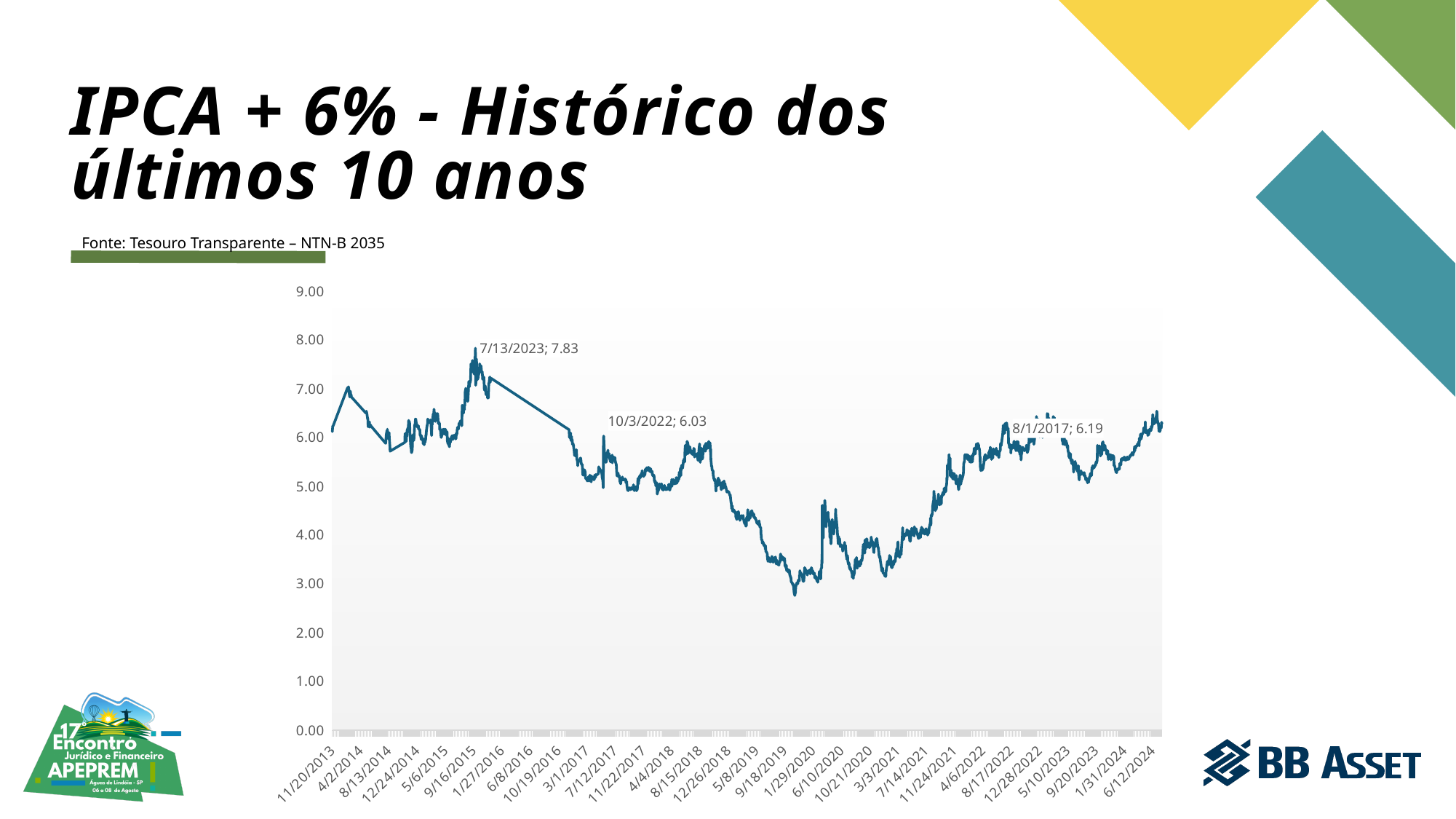
Is the value of the line at 11/20/2013 greater or less than 5.00? greater What source is cited for the chart data? Tesouro Transparente – NTN-B 2035 What value is labeled on the chart for 10/3/2022? 6.03 How many data points on the chart have printed value labels? 3 Is the value of the line around 1/29/2020 greater or less than 4.00? less What kind of chart is shown on the slide? line chart Of the three labeled points on the chart, which date has the lowest value? 10/3/2022 What value is labeled on the chart for 7/13/2023? 7.83 What is the difference between the labeled values for 7/13/2023 and 10/3/2022? 1.80 What value is labeled on the chart for 8/1/2017? 6.19 Which labeled value is larger: 8/1/2017 or 10/3/2022? 8/1/2017 Of the three labeled points on the chart, which date has the highest value? 7/13/2023